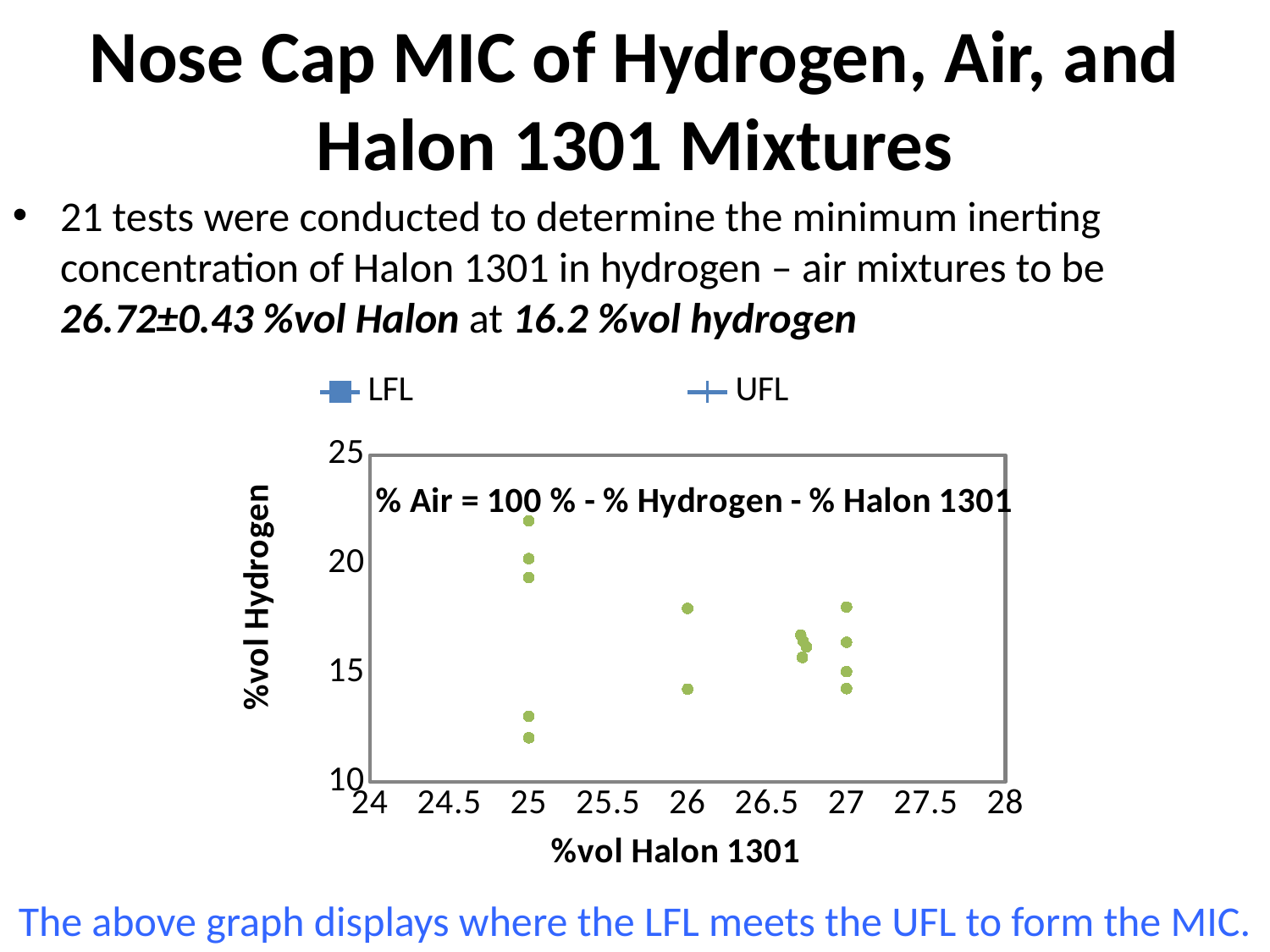
At which %vol Halon 1301 value does the point with the lowest %vol Hydrogen appear? 25 What are the two series named in the chart legend? LFL and UFL At which %vol Halon 1301 value does the point with the highest %vol Hydrogen appear? 25 Is the upper plotted point at 26 %vol Halon 1301 greater or less than 15 %vol Hydrogen? greater Is the highest plotted point at 27 %vol Halon 1301 greater or less than 20 %vol Hydrogen? less What is the title of the chart's x axis? %vol Halon 1301 What kind of chart is shown on the slide? scatter chart Is the lower plotted point at 26 %vol Halon 1301 greater or less than 15 %vol Hydrogen? less Which has the higher %vol Hydrogen: the topmost point at 25 %vol Halon 1301 or the topmost point at 27 %vol Halon 1301? the topmost point at 25 %vol Halon 1301 How many series does the chart legend list? 2